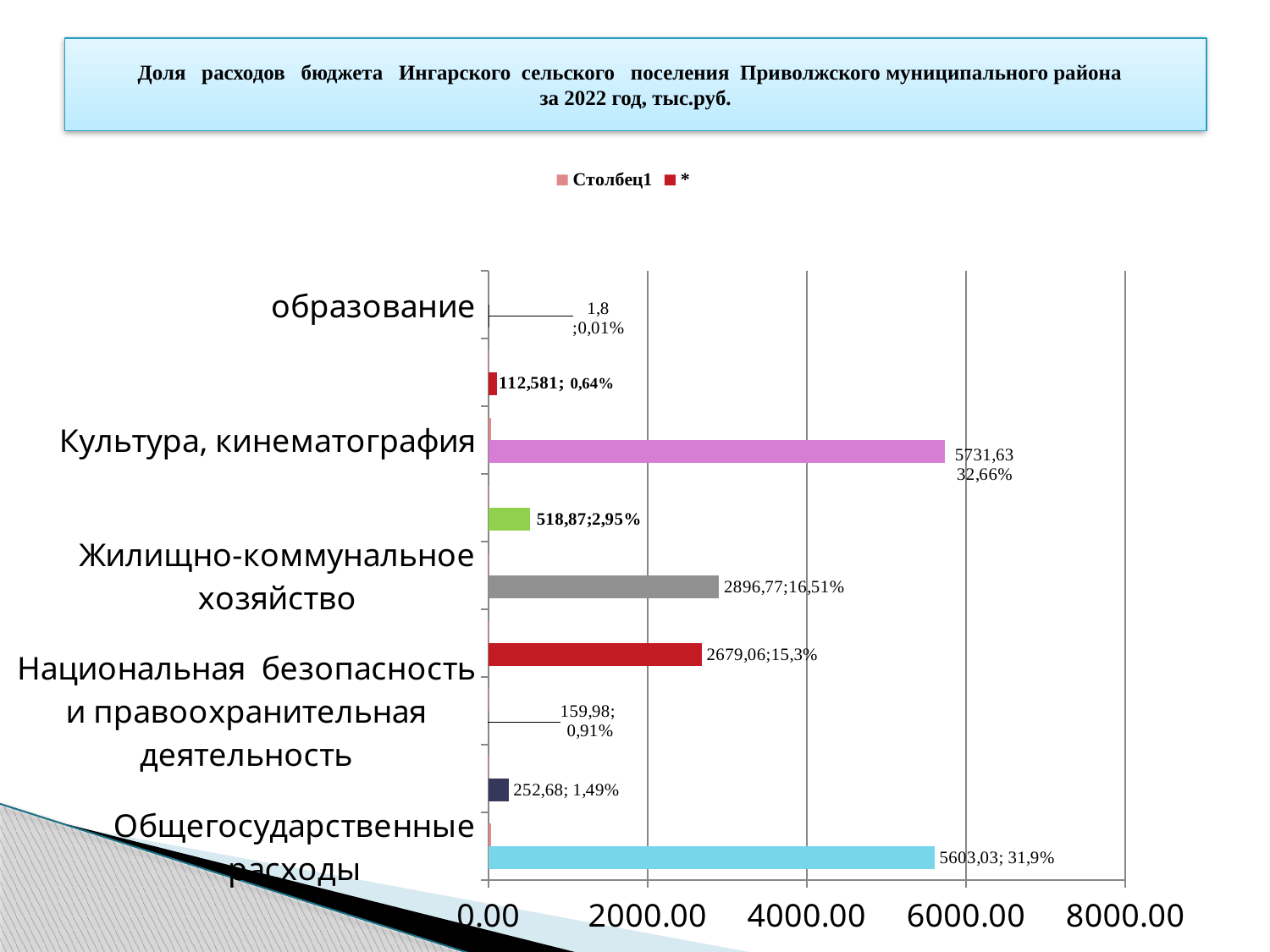
Is the value for Жилищно-коммунальное хозяйство greater or less than 4000.00? less What are the two legend entries? Столбец1 and * What kind of chart is shown on the slide? bar chart Which is larger, the bar for Культура, кинематография or the bar for Общегосударственные расходы? Культура, кинематография What value is labelled on the bar for Культура, кинематография? 5731,63; 32,66% What value is labelled on the bar for Общегосударственные расходы? 5603,03; 31,9% What value is labelled on the bar for Жилищно-коммунальное хозяйство? 2896,77; 16,51% Which category has the largest bar in the chart? Культура, кинематография What value is labelled on the bar for образование? 1,8; 0,01% What is the title of the slide's chart? Доля расходов бюджета Ингарского сельского поселения Приволжского муниципального района за 2022 год, тыс.руб. How many category labels are shown on the vertical axis? 5 How many series does the legend list? 2